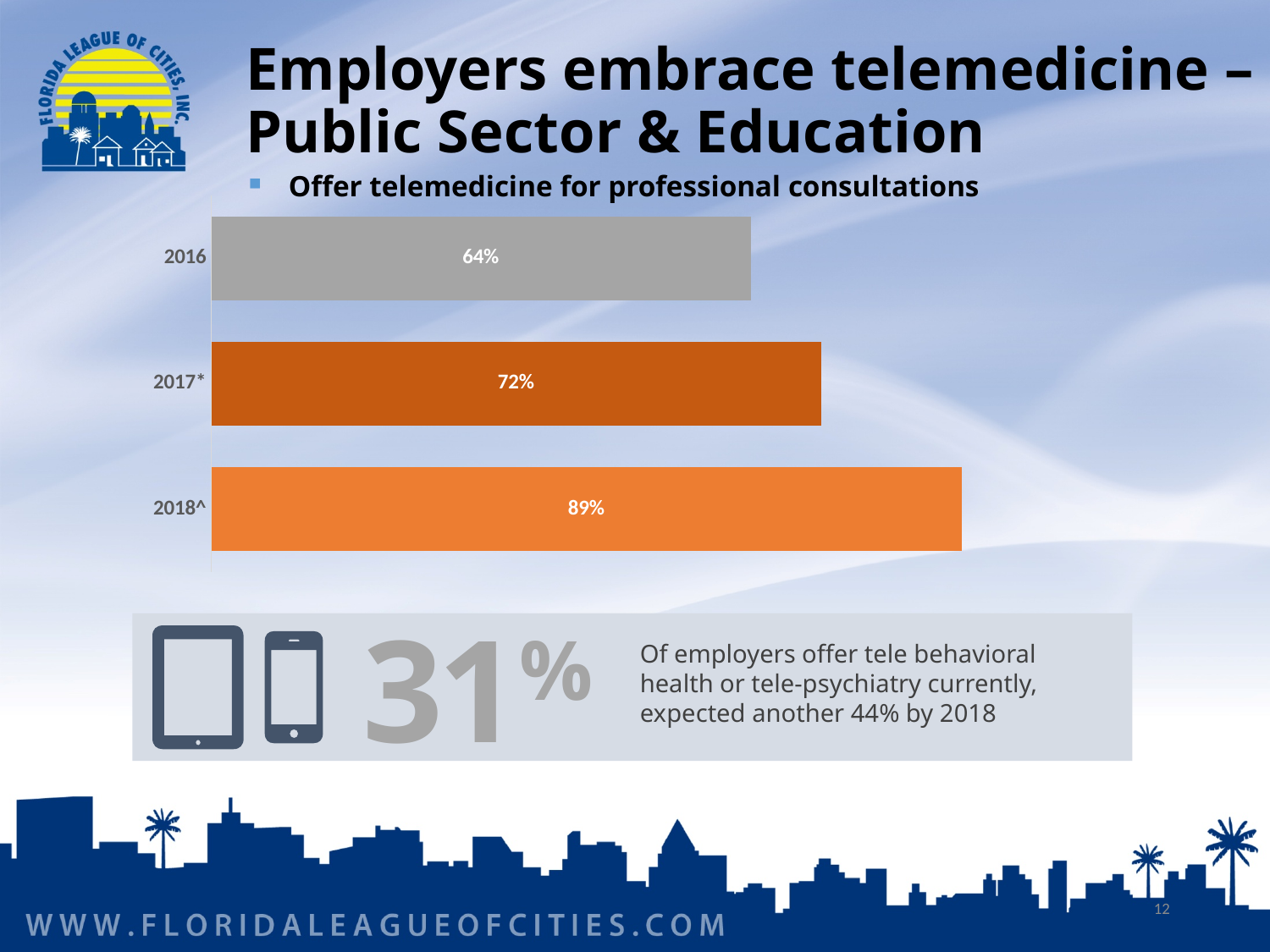
What percentage of employers offered telemedicine for professional consultations in 2016? 64% What is the difference between the 2017* value and the 2016 value? 8% Which year has the lowest value in the chart? 2016 Which year has the highest value in the chart? 2018^ What is the value shown for 2017*? 72% What kind of chart is shown on the slide? Bar chart How many years (bars) are shown in the chart? 3 What colour is the bar for 2016? Gray What is the value shown for 2018^? 89% What is the difference between the 2018^ value and the 2016 value? 25% Which is larger, the value for 2017* or the value for 2018^? 2018^ Do the values rise or fall from 2016 to 2018^? Rise